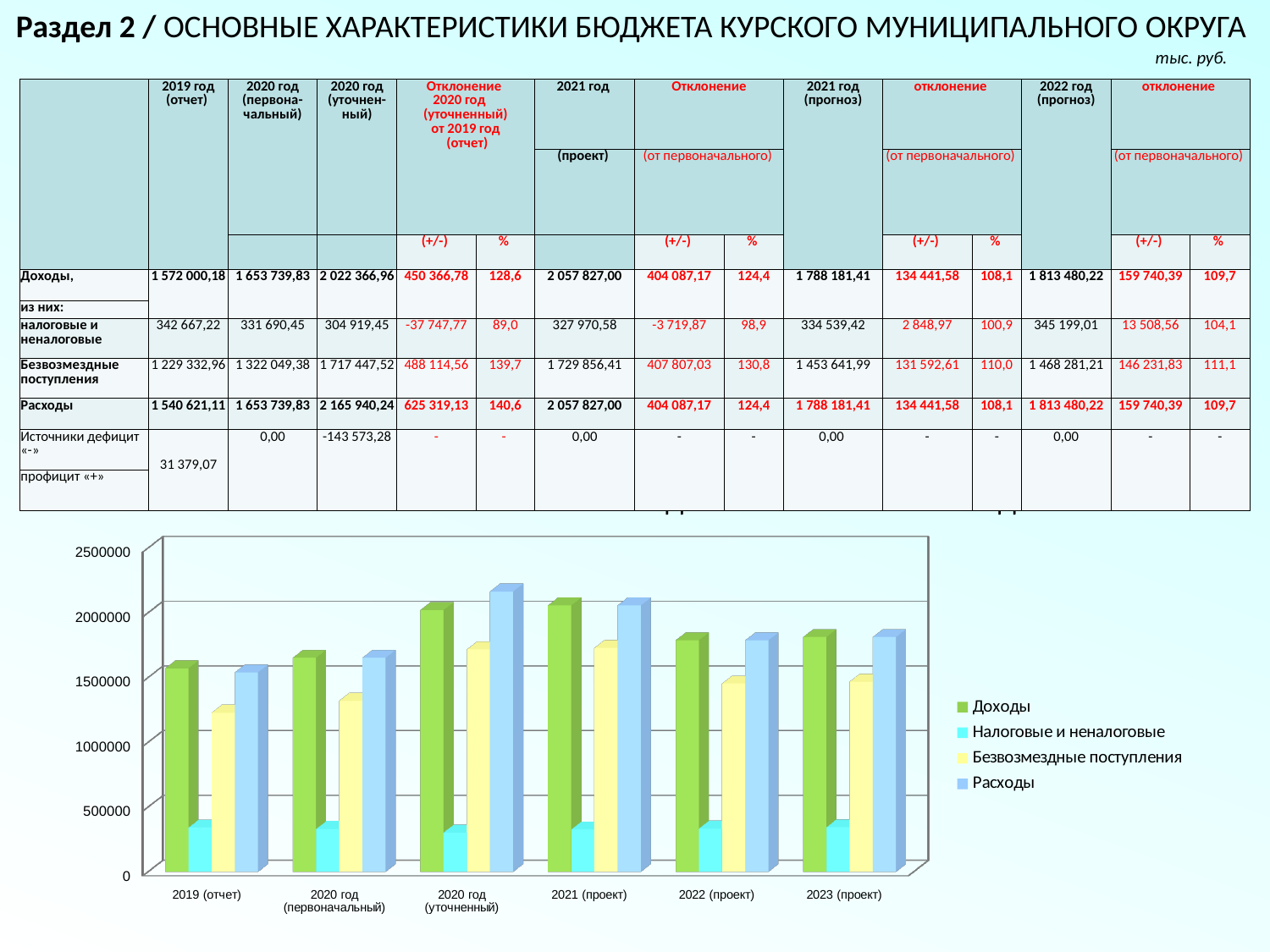
In the chart, which is larger for 2020 год (уточненный): Доходы or Расходы? Расходы In the chart, which category has the highest value for Расходы? 2020 год (уточненный) In the chart, which series has the lowest values across all categories? Налоговые и неналоговые What colour represents Расходы in the chart legend? Light blue In the chart, is the value for Безвозмездные поступления in 2019 (отчет) greater or less than 1000000? greater What kind of chart is shown at the bottom of the slide? Bar chart How many categories are shown along the x axis of the chart? 6 In the chart, is the value for Налоговые и неналоговые in 2019 (отчет) greater or less than 500000? less In the chart, is the value for Расходы in 2020 год (уточненный) greater or less than 2000000? greater In the chart, do the values for Доходы rise or fall from 2019 (отчет) to 2020 год (уточненный)? rise How many series does the chart legend list? 4